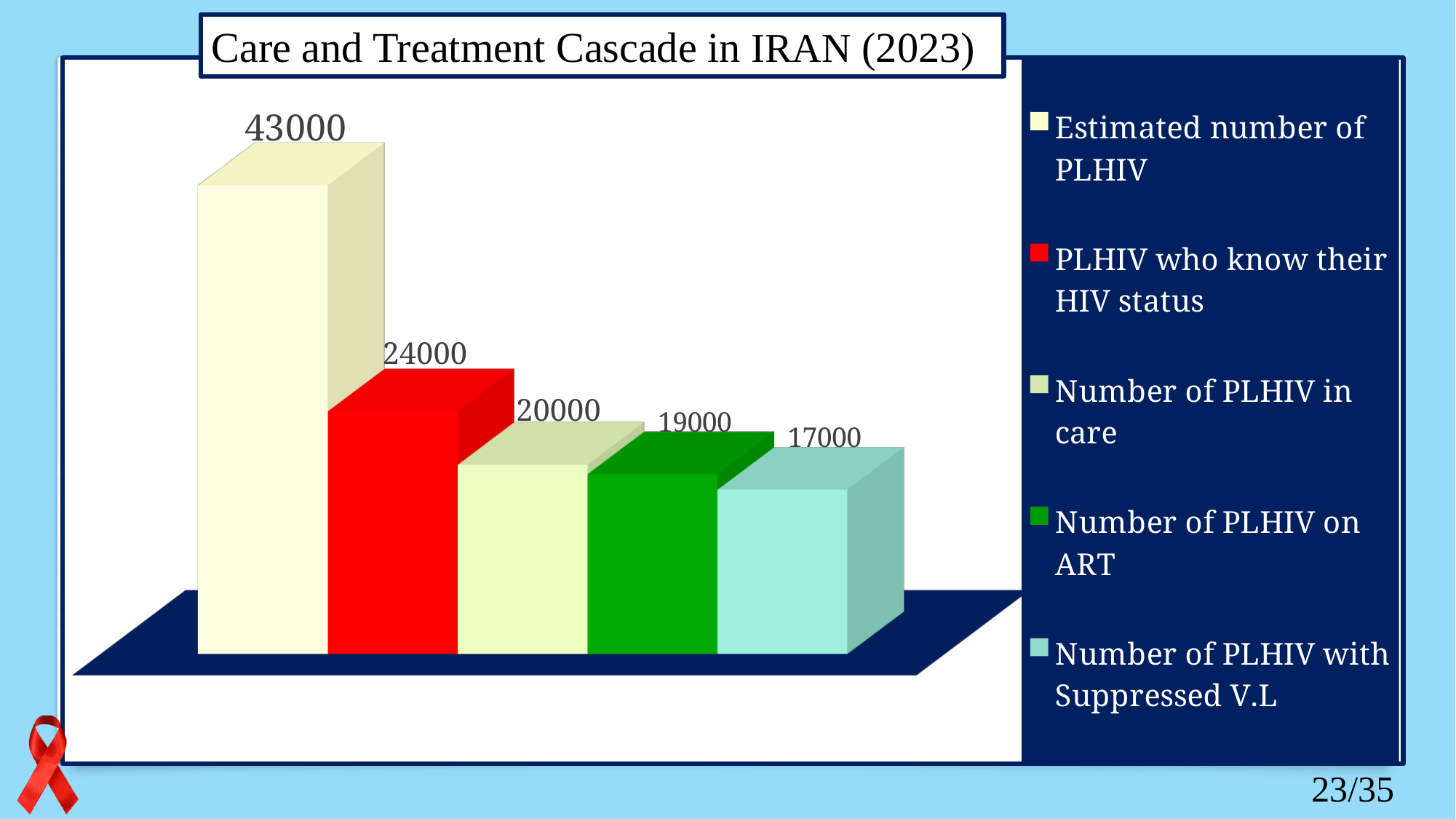
Which category has the lowest value? Number of PLHIV with Suppressed V.L What kind of chart is shown on the slide? Bar chart What is the number of PLHIV on ART? 19000 Which category has the highest value? Estimated number of PLHIV What is the value for PLHIV who know their HIV status? 24000 Which is larger: the number of PLHIV in care or the number of PLHIV on ART? Number of PLHIV in care What is the difference between the number of PLHIV on ART and the number of PLHIV with suppressed V.L? 2000 How many bars are shown on the chart? 5 What is the number of PLHIV with suppressed V.L? 17000 What is the number of PLHIV in care? 20000 What is the estimated number of PLHIV shown on the chart? 43000 What is the difference between the estimated number of PLHIV and the number of PLHIV who know their HIV status? 19000